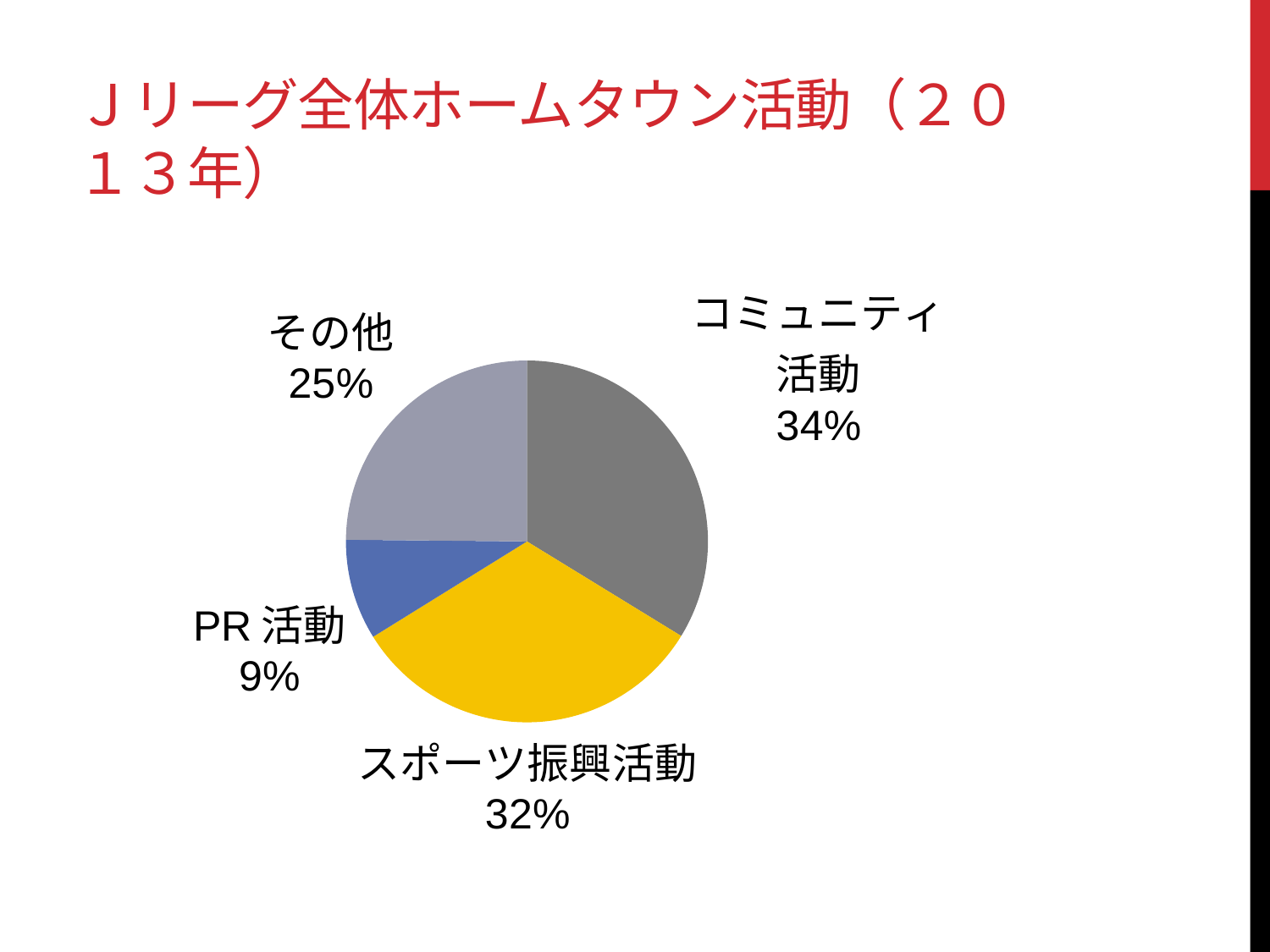
What percentage does コミュニティ活動 account for? 34% What is the difference in percentage points between コミュニティ活動 and PR活動? 25 What is the title of the chart on the slide? Ｊリーグ全体ホームタウン活動（２０１３年） Which category has the largest share of the pie? コミュニティ活動 What percentage does スポーツ振興活動 account for? 32% Which category has the smallest share of the pie? PR活動 What type of chart is shown on the slide? Pie chart Which is larger, the share for その他 or the share for PR活動? その他 How many categories are shown in the pie chart? 4 What percentage does PR活動 account for? 9% What percentage does その他 account for? 25% What is the difference in percentage points between スポーツ振興活動 and その他? 7